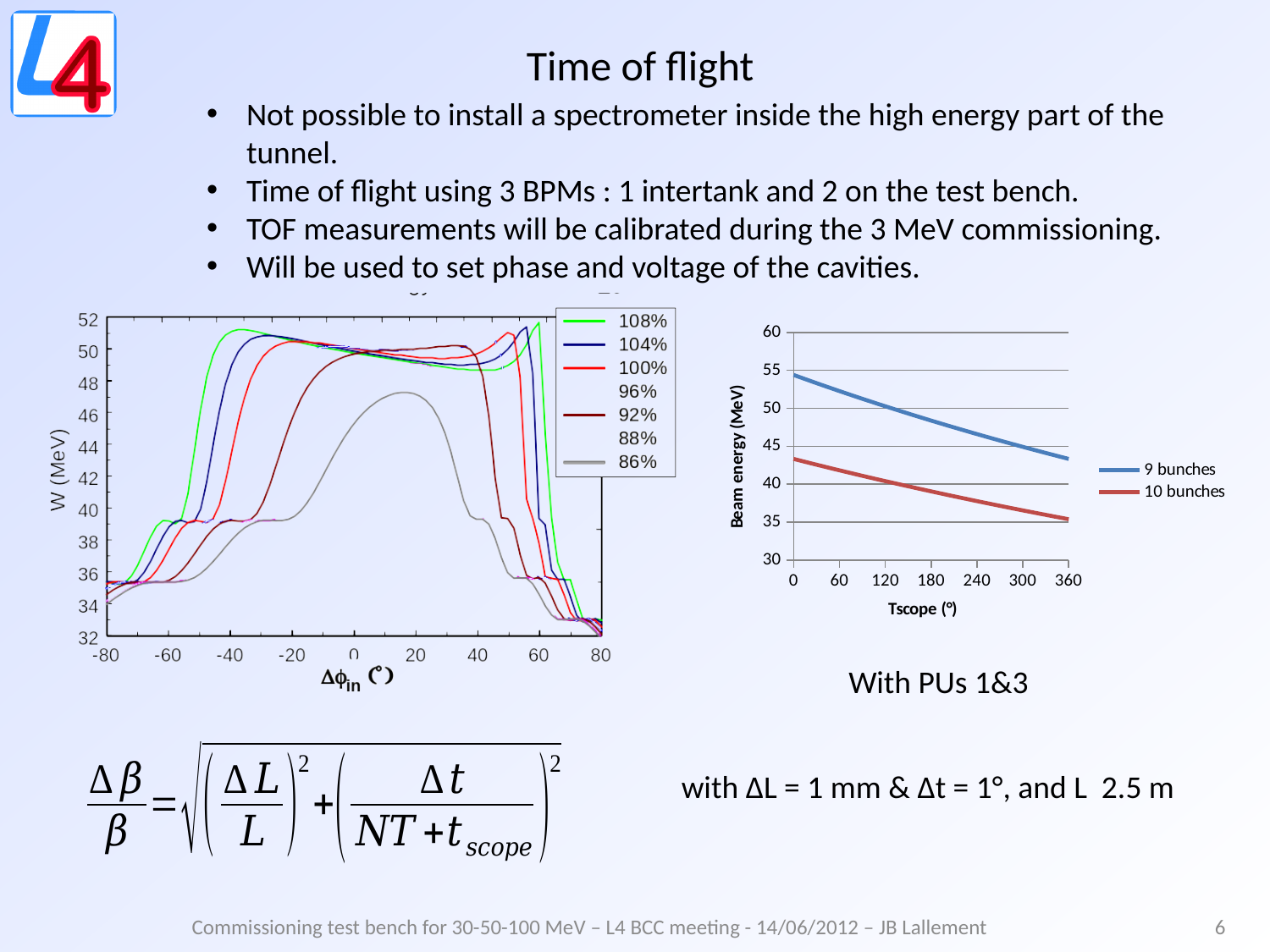
How many series does the legend of the left chart (W (MeV) vs Δφin) list? 7 What kind of chart is the chart on the right (Beam energy vs Tscope)? line chart In the left chart (W (MeV) vs Δφin), which series reaches the lowest peak W value? 86% What kind of chart is the chart on the left (W (MeV) vs Δφin)? line chart In the right chart (Beam energy vs Tscope), does beam energy rise or fall as Tscope increases? fall In the right chart (Beam energy vs Tscope), is the beam energy for 9 bunches at Tscope = 0 greater or less than 50? greater In the left chart (W (MeV) vs Δφin), is the peak W value of the 86% series greater or less than 50? less In the right chart (Beam energy vs Tscope), at Tscope = 0, which series has the higher beam energy, 9 bunches or 10 bunches? 9 bunches What is the x-axis title of the right chart (Beam energy vs Tscope)? Tscope (°) In the right chart (Beam energy vs Tscope), is the beam energy for 10 bunches at Tscope = 360 greater or less than 40? less What is the y-axis title of the left chart? W (MeV) How many series does the legend of the right chart (Beam energy vs Tscope) list? 2